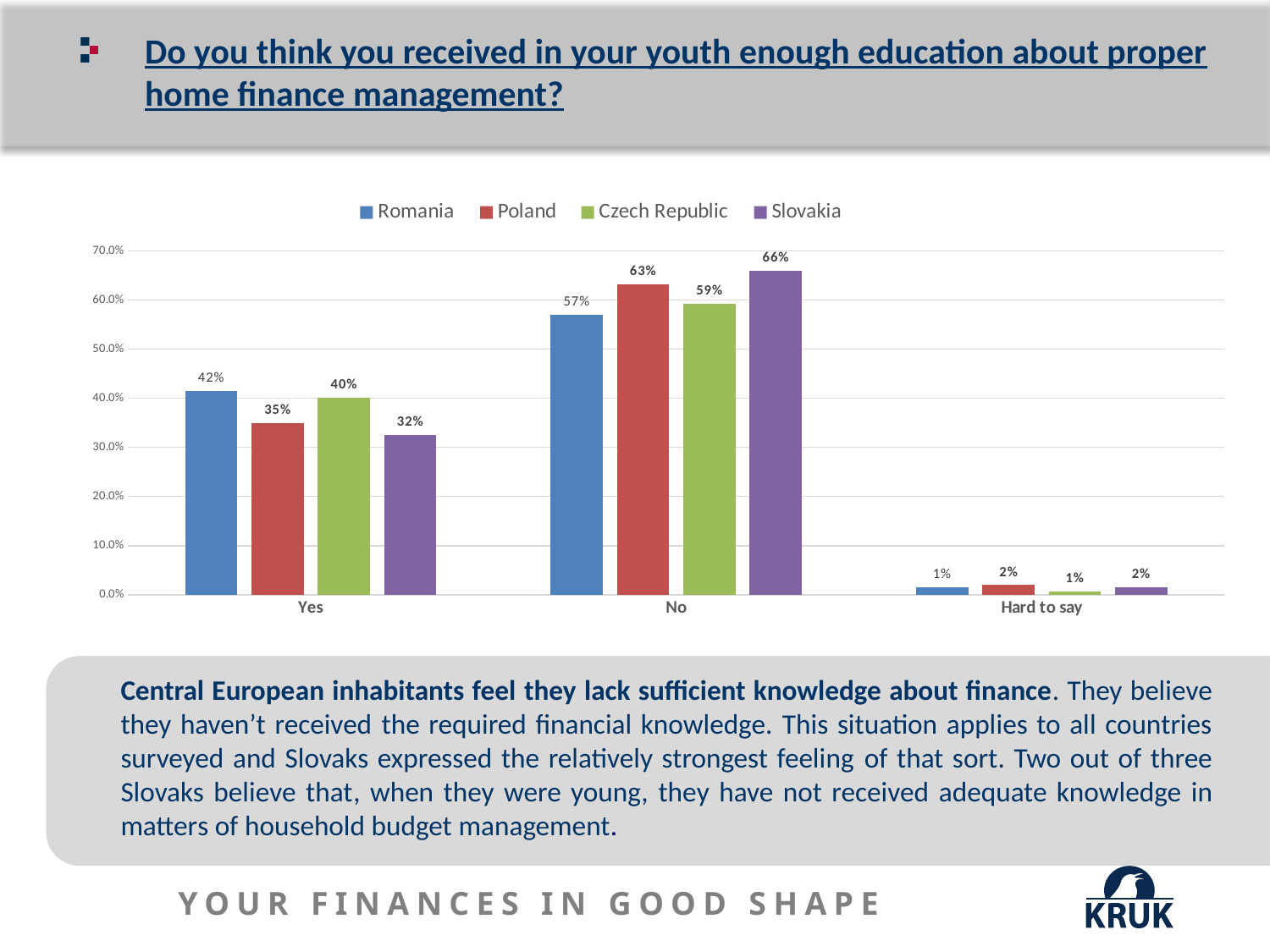
What percentage of Poland respondents answered "Hard to say"? 2% What is the difference between Slovakia's "No" and "Yes" values? 34% How many series does the legend list? 4 Which country has the highest value for "No"? Slovakia Which country has the lowest value for "Yes"? Slovakia Which colour represents Slovakia in the chart? Purple What percentage of Slovakia respondents answered "No"? 66% Which is larger: the Czech Republic value for "Yes" or the Poland value for "Yes"? Czech Republic What percentage of Romania respondents answered "Yes"? 42% What kind of chart is shown on the slide? Bar chart What is the difference between Poland's and Romania's values for "No"? 6% How many answer categories are shown on the x axis? 3